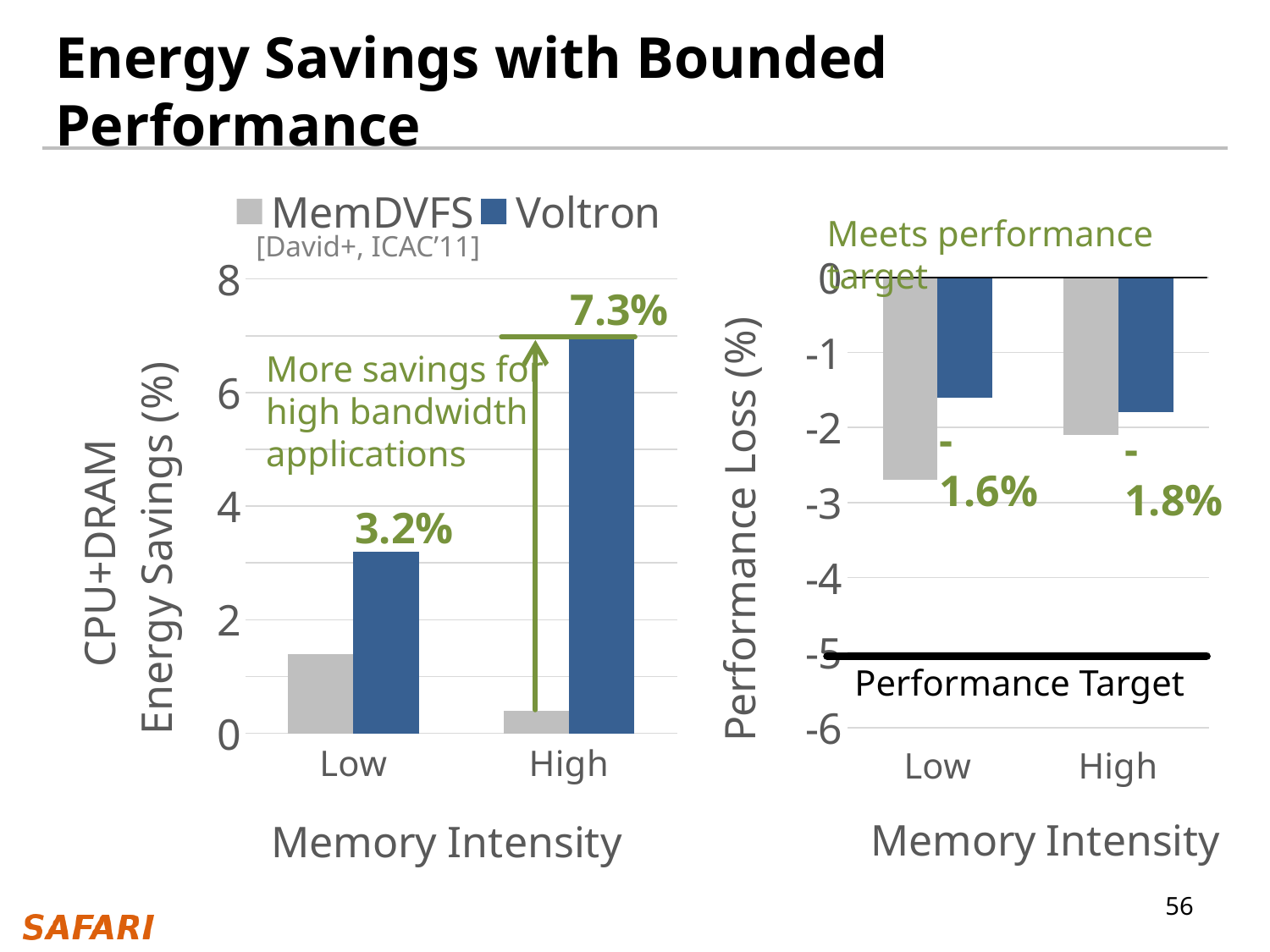
In the left chart (CPU+DRAM Energy Savings), what is the difference between Voltron's savings at High and at Low memory intensity? 4.1% In the left chart (CPU+DRAM Energy Savings), is the value for MemDVFS at Low memory intensity greater or less than 2? less What kind of chart is the left chart (CPU+DRAM Energy Savings)? bar chart In the left chart (CPU+DRAM Energy Savings), what is the energy savings value for Voltron at High memory intensity? 7.3% How many series does the legend list for the charts on this slide? 2 In the right chart (Performance Loss), what is the performance loss for Voltron at High memory intensity? -1.8% In the left chart (CPU+DRAM Energy Savings), do Voltron's values rise or fall from Low to High memory intensity? rise In the left chart (CPU+DRAM Energy Savings), what is the energy savings value for Voltron at Low memory intensity? 3.2% In the right chart (Performance Loss), what is the performance loss for Voltron at Low memory intensity? -1.6% In the left chart (CPU+DRAM Energy Savings), which series has the larger value at High memory intensity, MemDVFS or Voltron? Voltron In the right chart (Performance Loss), at what y-axis value is the Performance Target line drawn? -5 In the right chart (Performance Loss), is the value for MemDVFS at Low memory intensity greater or less than -2? less